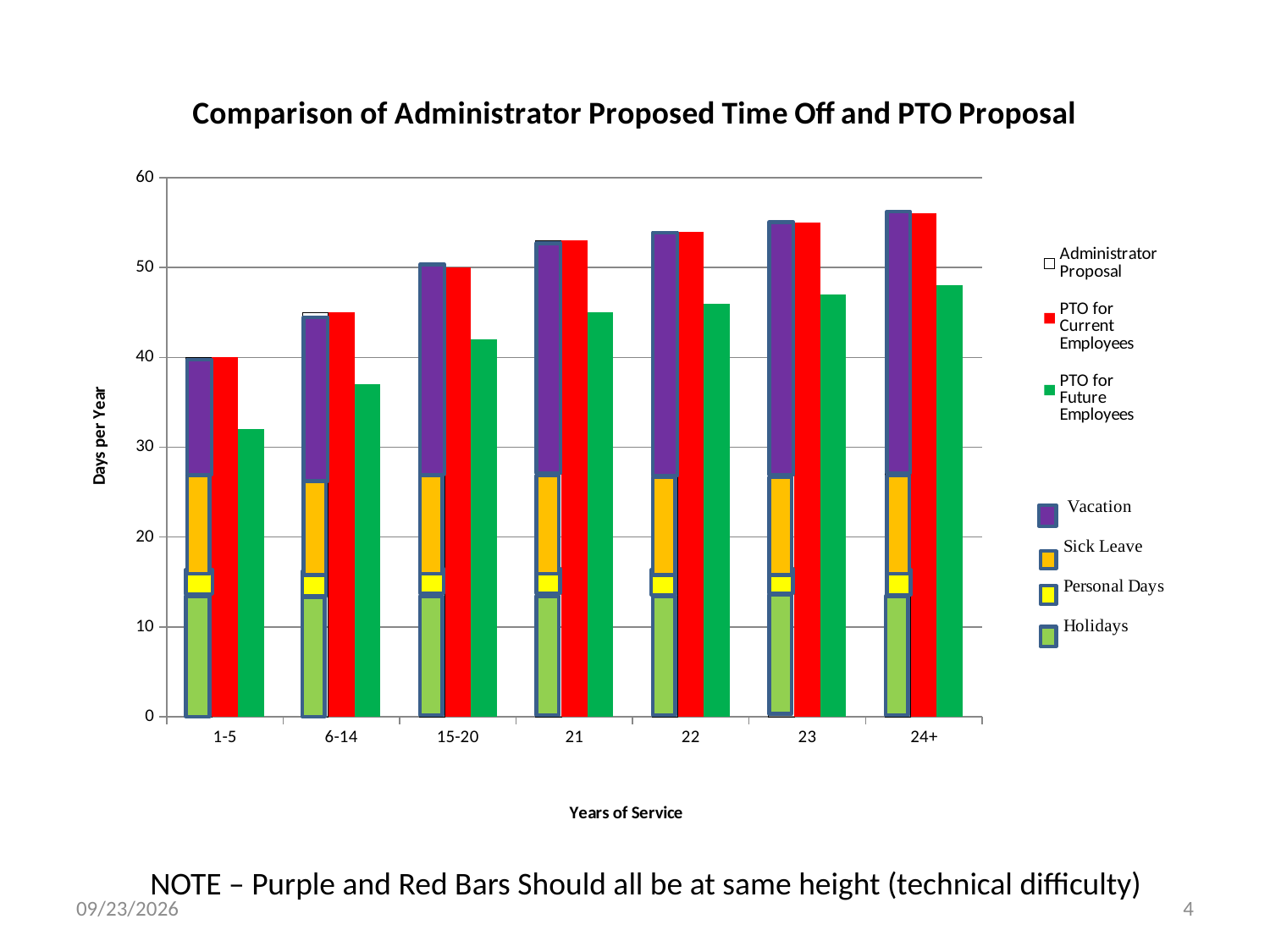
Is the value for PTO for Future Employees at 6-14 years greater or less than 40? less Is the value for PTO for Current Employees at 24+ years greater or less than 50? greater Which years-of-service category has the lowest value for PTO for Future Employees? 1-5 How many years-of-service categories are shown on the x axis? 7 Is the value for PTO for Future Employees at 24+ years greater or less than 50? less At 1-5 years of service, which is larger: PTO for Current Employees or PTO for Future Employees? PTO for Current Employees How many series does the chart legend list (Administrator Proposal, PTO for Current Employees, PTO for Future Employees)? 3 What is the value for PTO for Current Employees at 15-20 years of service? 50 Which years-of-service category has the highest value for PTO for Future Employees? 24+ Do the values for PTO for Future Employees rise or fall as years of service increase along the x axis? rise What is the value for PTO for Current Employees at 1-5 years of service? 40 What kind of chart is shown on the slide? bar chart